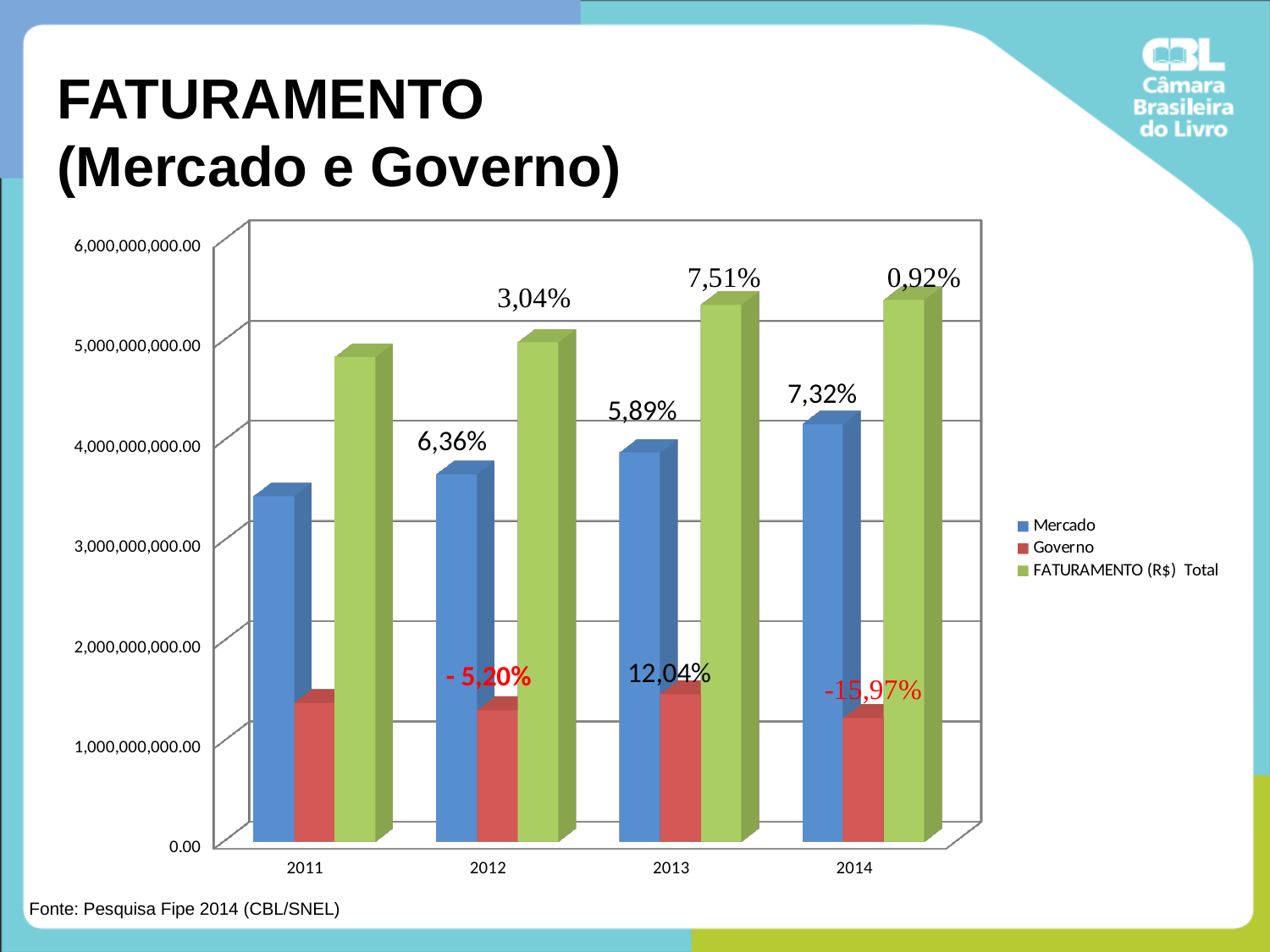
What percentage label is shown above the FATURAMENTO (R$) Total bar for 2012? 3,04% How many years are shown on the x axis? 4 Is the value for Mercado in 2011 greater or less than 4,000,000,000.00? less What percentage label is shown for the Governo series in 2013? 12,04% What percentage label is shown for the Governo series in 2014? -15,97% Do the Mercado values rise or fall from 2011 to 2014? rise What percentage label is shown above the Mercado bar for 2014? 7,32% In which year is the Mercado bar highest? 2014 What kind of chart is shown on the slide? bar chart Is the value for FATURAMENTO (R$) Total in 2013 greater or less than 5,000,000,000.00? greater Is the value for Governo in 2013 greater or less than 1,000,000,000.00? greater How many series does the legend list? 3